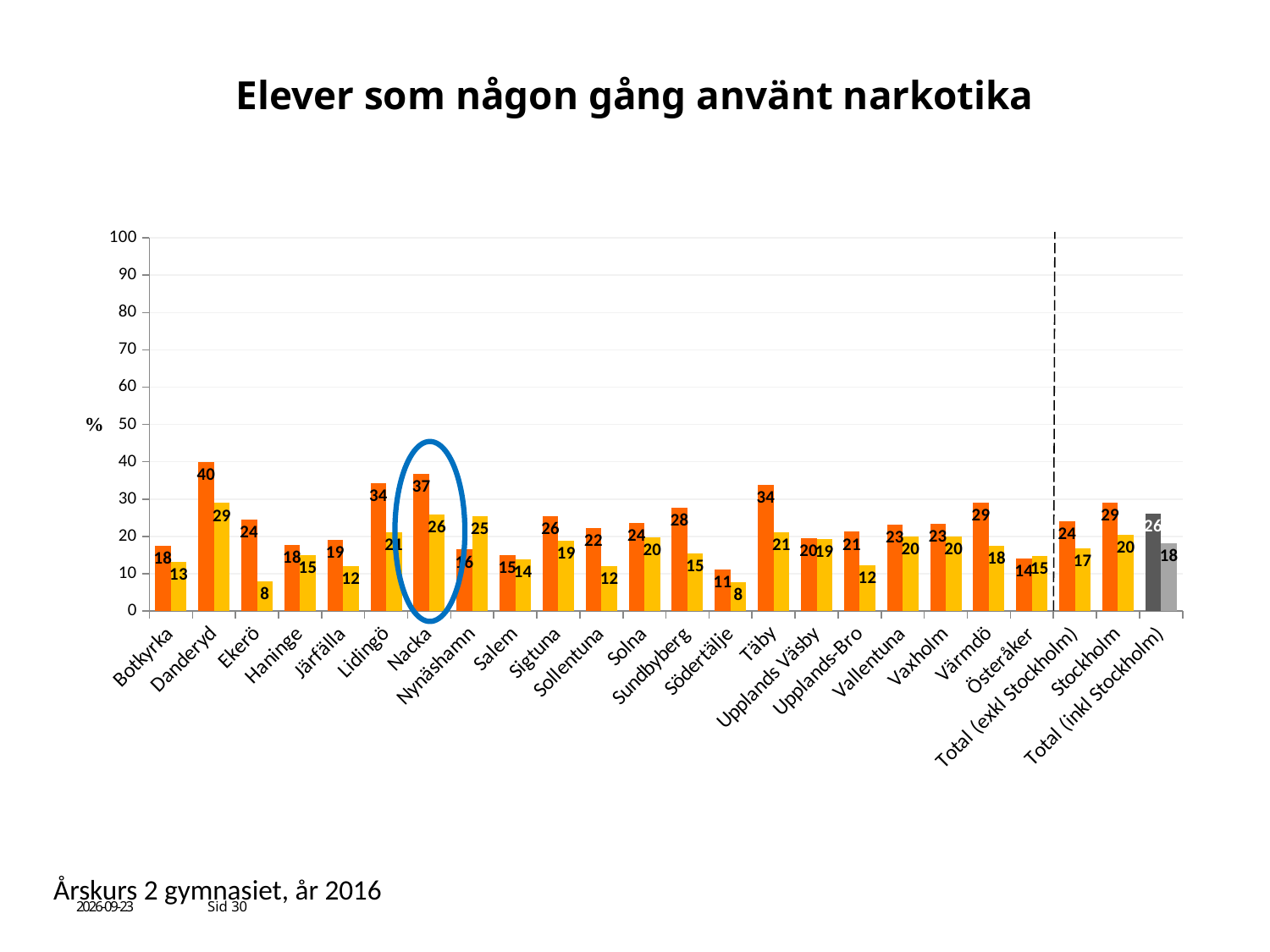
Which is larger for Nynäshamn, the orange bar or the yellow bar? the yellow bar Which municipality has the lowest orange bar? Södertälje What is the value of the yellow bar for Nacka? 26 What is the title of the chart? Elever som någon gång använt narkotika How many categories are shown on the x axis? 24 What kind of chart is shown on the slide? bar chart Is the orange bar for Lidingö greater or less than 30? greater What is the difference between the orange and yellow bars for Ekerö? 16 Which municipality is circled in blue on the chart? Nacka What is the value of the orange bar for Danderyd? 40 Which municipality has the highest orange bar? Danderyd